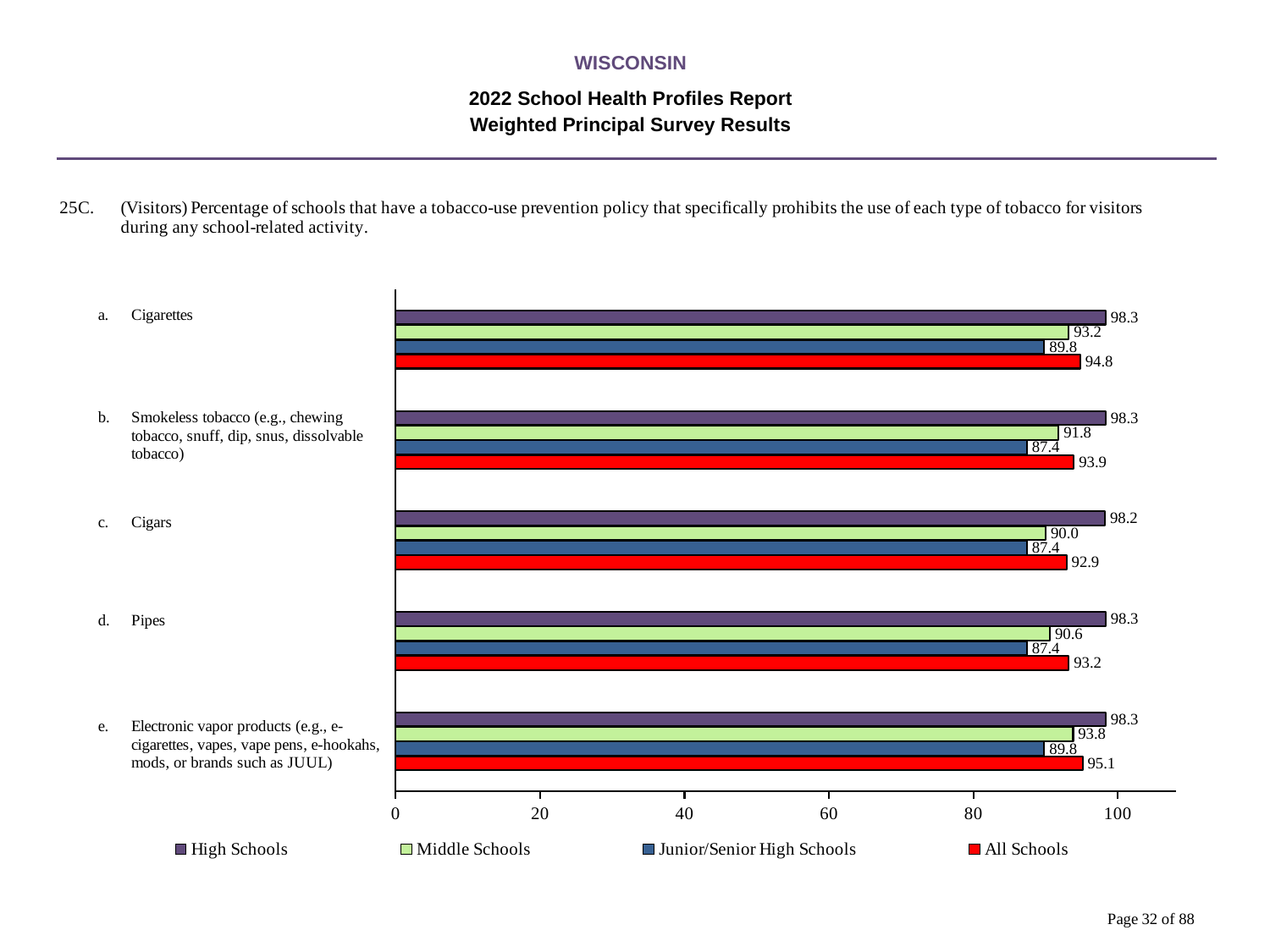
What is the value for Middle Schools for Cigarettes? 93.2 What is the difference between the High Schools and Junior/Senior High Schools values for Smokeless tobacco? 10.9 What is the value for High Schools for Electronic vapor products? 98.3 Is the value for Junior/Senior High Schools for Cigarettes greater or less than 80? greater Which category has the highest value for All Schools? Electronic vapor products How many categories are shown on the chart? 5 What is the value for All Schools for Cigars? 92.9 Which category has the lowest value for Middle Schools? Cigars What kind of chart is shown on the slide? Bar chart What is the value for Junior/Senior High Schools for Pipes? 87.4 Which is larger for Pipes: the Middle Schools value or the All Schools value? All Schools How many series does the legend list? 4